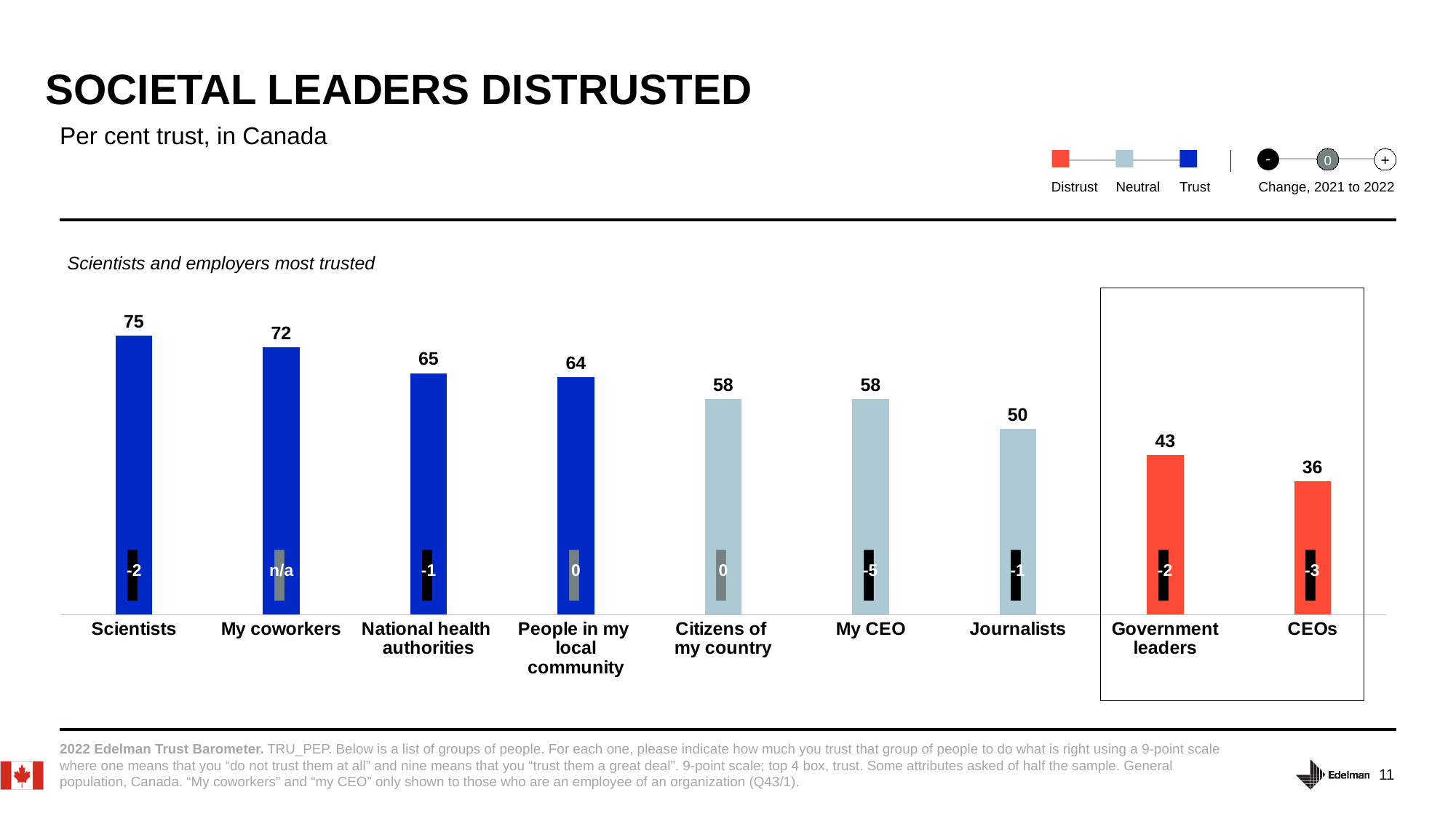
What is the per cent trust value for Journalists? 50 Which has a higher per cent trust, National health authorities or Journalists? National health authorities What is the per cent trust value for Scientists? 75 What kind of chart is shown on the slide? Bar chart What is the difference in per cent trust between My coworkers and Government leaders? 29 Which three categories does the legend list for the bar colours? Distrust, Neutral, Trust How many groups are shown on the chart? 9 What is the change from 2021 to 2022 shown for My CEO? -5 Which group has the lowest per cent trust? CEOs What is the difference in per cent trust between Scientists and CEOs? 39 What is the per cent trust value for CEOs? 36 Which group has the highest per cent trust? Scientists